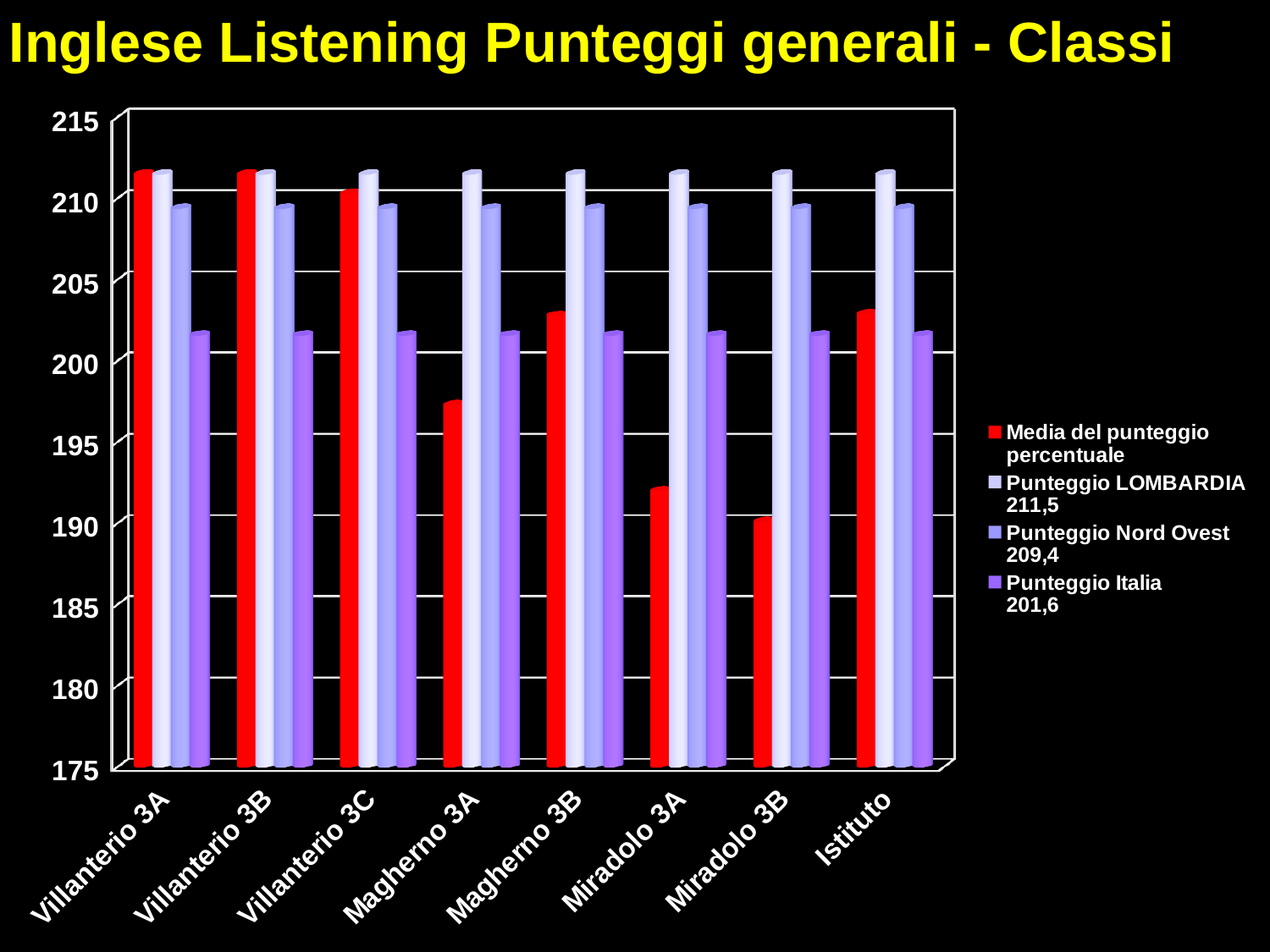
What is the title of the chart? Inglese Listening Punteggi generali - Classi Is the Media del punteggio percentuale for Miradolo 3A greater or less than 195? less What kind of chart is shown on the slide? bar chart How many classes/categories are shown on the x axis? 8 Which has a higher Media del punteggio percentuale, Magherno 3A or Magherno 3B? Magherno 3B What is the Punteggio LOMBARDIA value given in the legend? 211,5 How many series does the legend list? 4 What is the difference between the Punteggio LOMBARDIA and the Punteggio Italia? 9,9 Is the Media del punteggio percentuale for Magherno 3A greater or less than 195? greater Which class has the lowest Media del punteggio percentuale? Miradolo 3B What is the Punteggio Nord Ovest value given in the legend? 209,4 What is the Punteggio Italia value given in the legend? 201,6